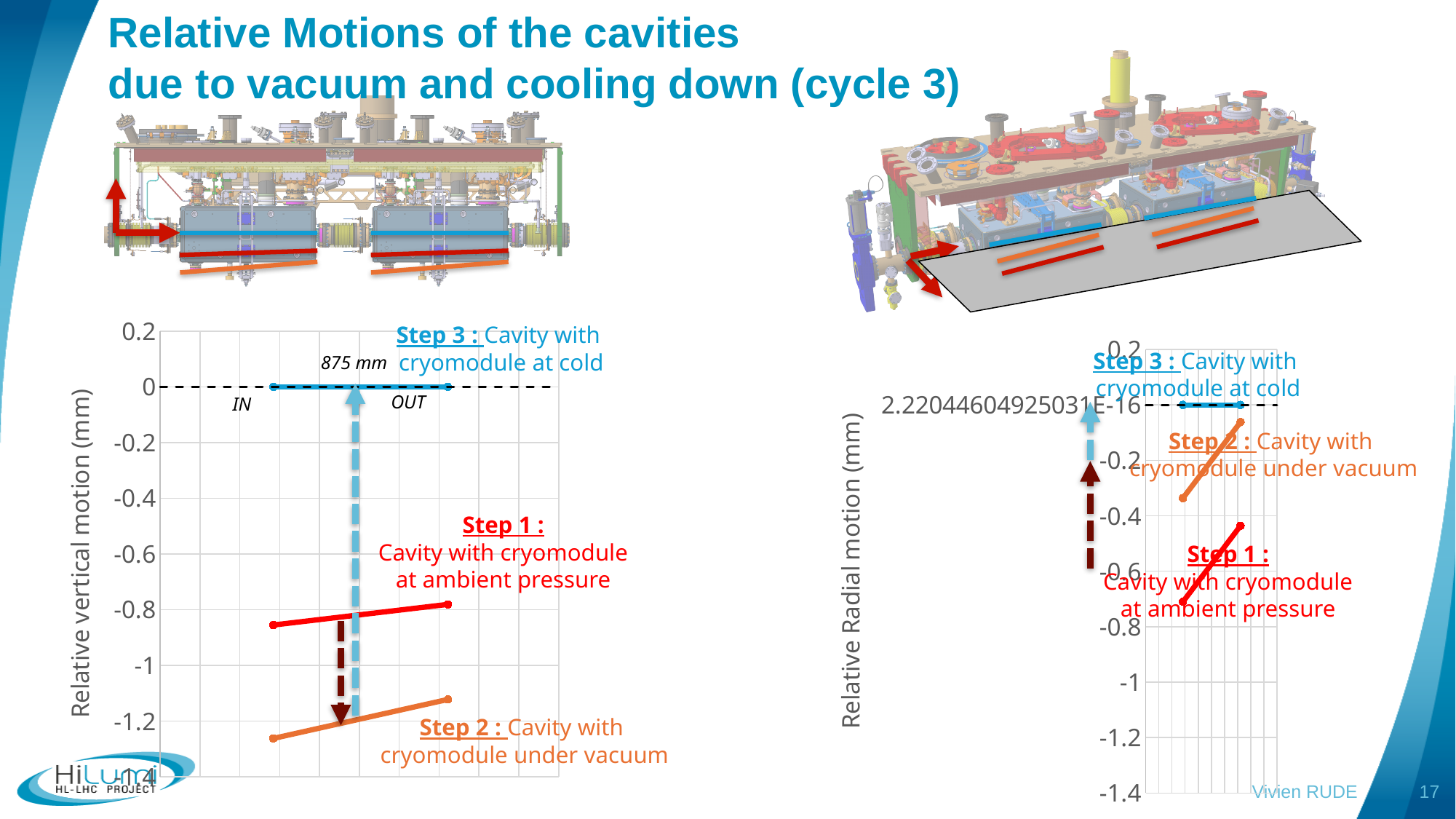
On the left chart (Relative vertical motion), is the Step 2 value at OUT greater or less than -1? less On the right chart (Relative Radial motion), is the lower (left) end of the Step 1 line greater or less than -0.6? less What is the y-axis title of the right chart? Relative Radial motion (mm) On the left chart (Relative vertical motion), how many steps (series) are plotted? 3 On the left chart (Relative vertical motion), what is the distance between the IN and OUT points as annotated? 875 mm On the left chart (Relative vertical motion), does the Step 1 line rise or fall from IN to OUT? rise On the right chart (Relative Radial motion), is the upper (right) end of the Step 2 line greater or less than -0.2? greater On the left chart (Relative vertical motion), at what value does the Step 3 (cryomodule at cold) line lie? 0 What kind of chart is the left chart titled 'Relative vertical motion (mm)'? line chart On the right chart (Relative Radial motion), which is higher, the Step 1 line or the Step 2 line? Step 2 On the left chart (Relative vertical motion), which step has the lowest values: Step 1, Step 2 or Step 3? Step 2